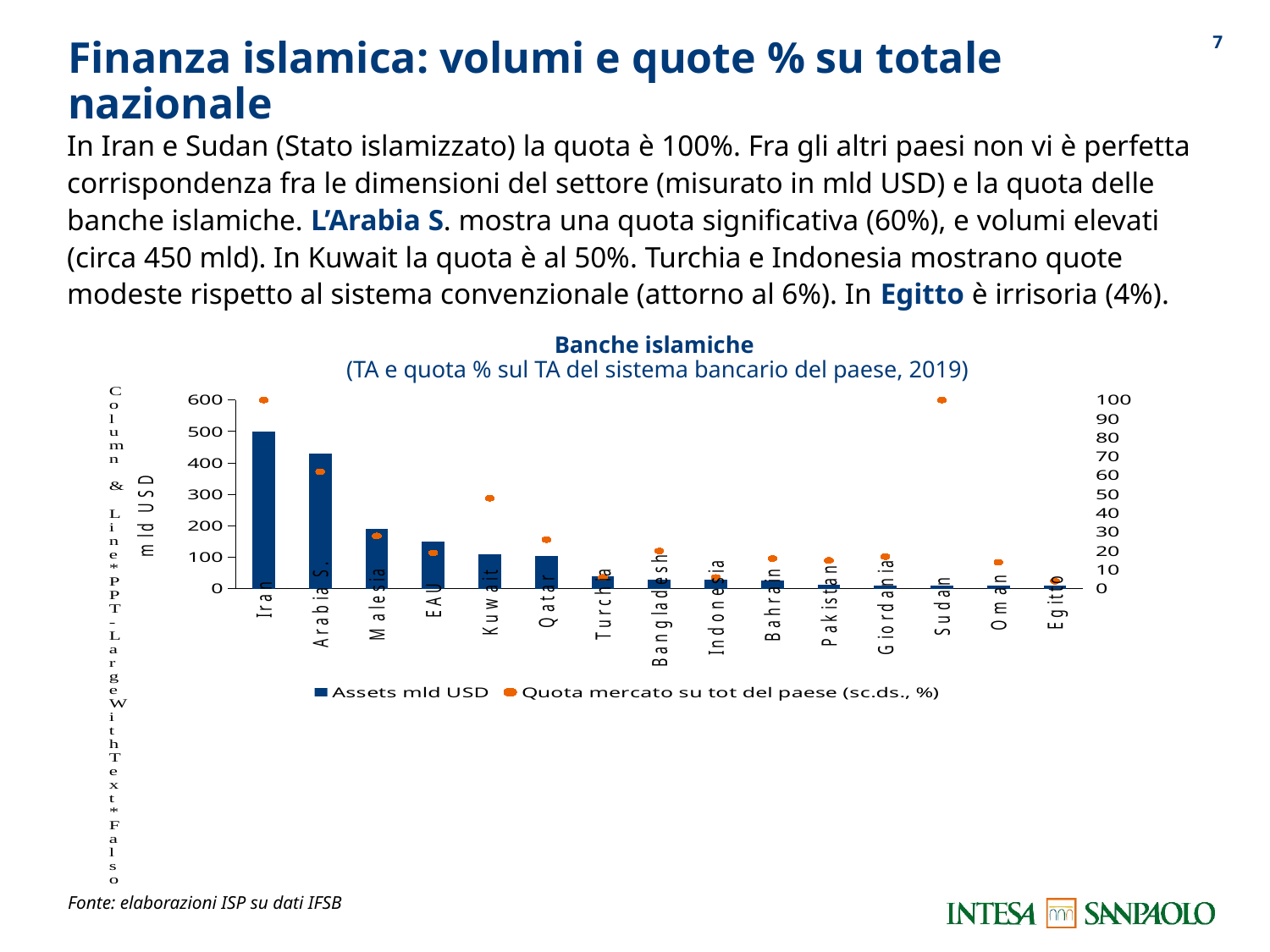
Which has a larger Assets mld USD value, Iran or Arabia S.? Iran Is the Assets mld USD value for Arabia S. greater or less than 400? greater Is the Quota mercato value for Arabia S. greater or less than 50? greater How many series does the chart legend list? 2 Is the Assets mld USD value for Turchia greater or less than 100? less How many countries are shown on the x axis of the chart? 15 Which has a larger Quota mercato value, Kuwait or Qatar? Kuwait Do the Assets mld USD bars generally rise or fall from left to right along the x axis? fall What is the title of the chart? Banche islamiche Which country has the highest value for Assets mld USD? Iran What kind of chart is shown on the slide? bar chart